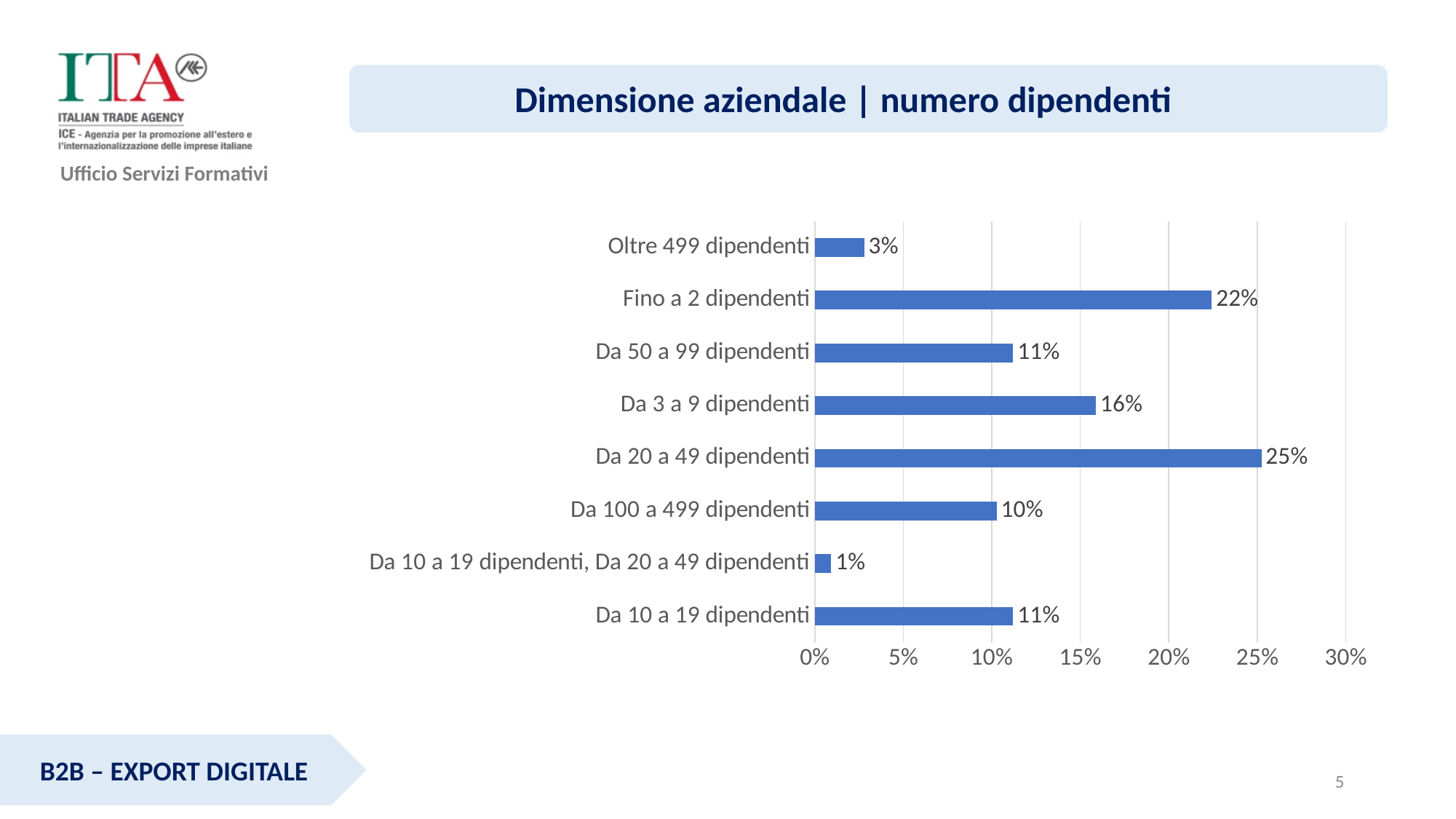
Which category has the highest value? Da 20 a 49 dipendenti What is the value for "Oltre 499 dipendenti"? 3% Which is larger, the value for "Da 3 a 9 dipendenti" or the value for "Da 50 a 99 dipendenti"? Da 3 a 9 dipendenti What is the difference between the values for "Da 20 a 49 dipendenti" and "Fino a 2 dipendenti"? 3% What is the value for "Da 20 a 49 dipendenti"? 25% What is the value for "Da 100 a 499 dipendenti"? 10% Is the value for "Fino a 2 dipendenti" greater or less than 20%? greater What is the title of the chart on the slide? Dimensione aziendale | numero dipendenti What is the value for "Fino a 2 dipendenti"? 22% How many categories are shown in the chart? 8 Which category has the lowest value? Da 10 a 19 dipendenti, Da 20 a 49 dipendenti What kind of chart is shown on the slide? bar chart